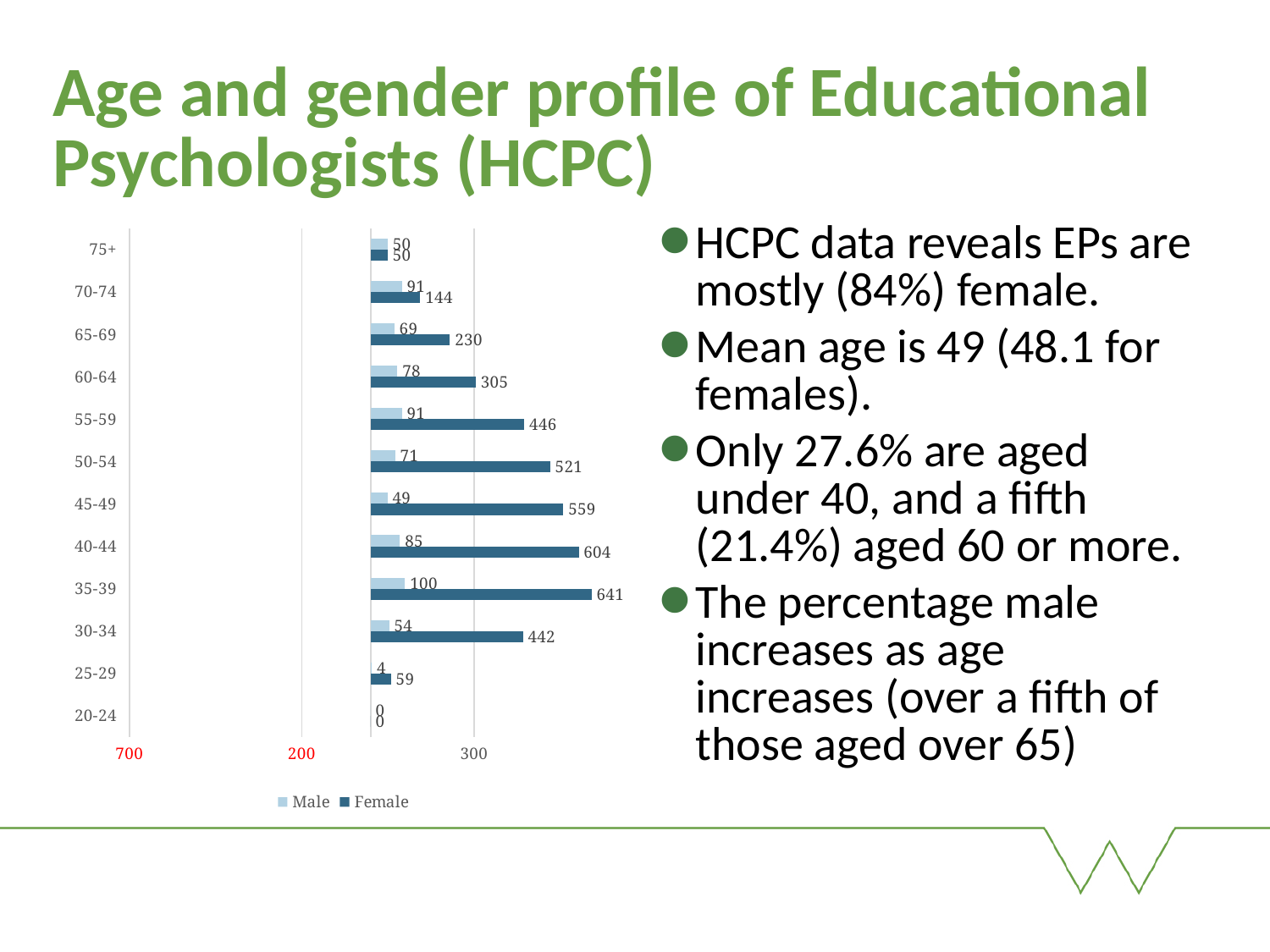
Which age group has the highest Male value? 35-39 What is the difference between the Female and Male values for the 35-39 age group? 541 What is the Female value for the 35-39 age group? 641 Which age group has the highest Female value? 35-39 How many age groups are shown on the chart? 12 What are the two series named in the chart legend? Male and Female How many series does the chart legend list? 2 What is the Male value for the 25-29 age group? 4 What is the Female value for the 60-64 age group? 305 What is the Male value for the 45-49 age group? 49 What type of chart is shown on the slide? bar chart Which is larger, the Female value for 50-54 or the Female value for 55-59? 50-54